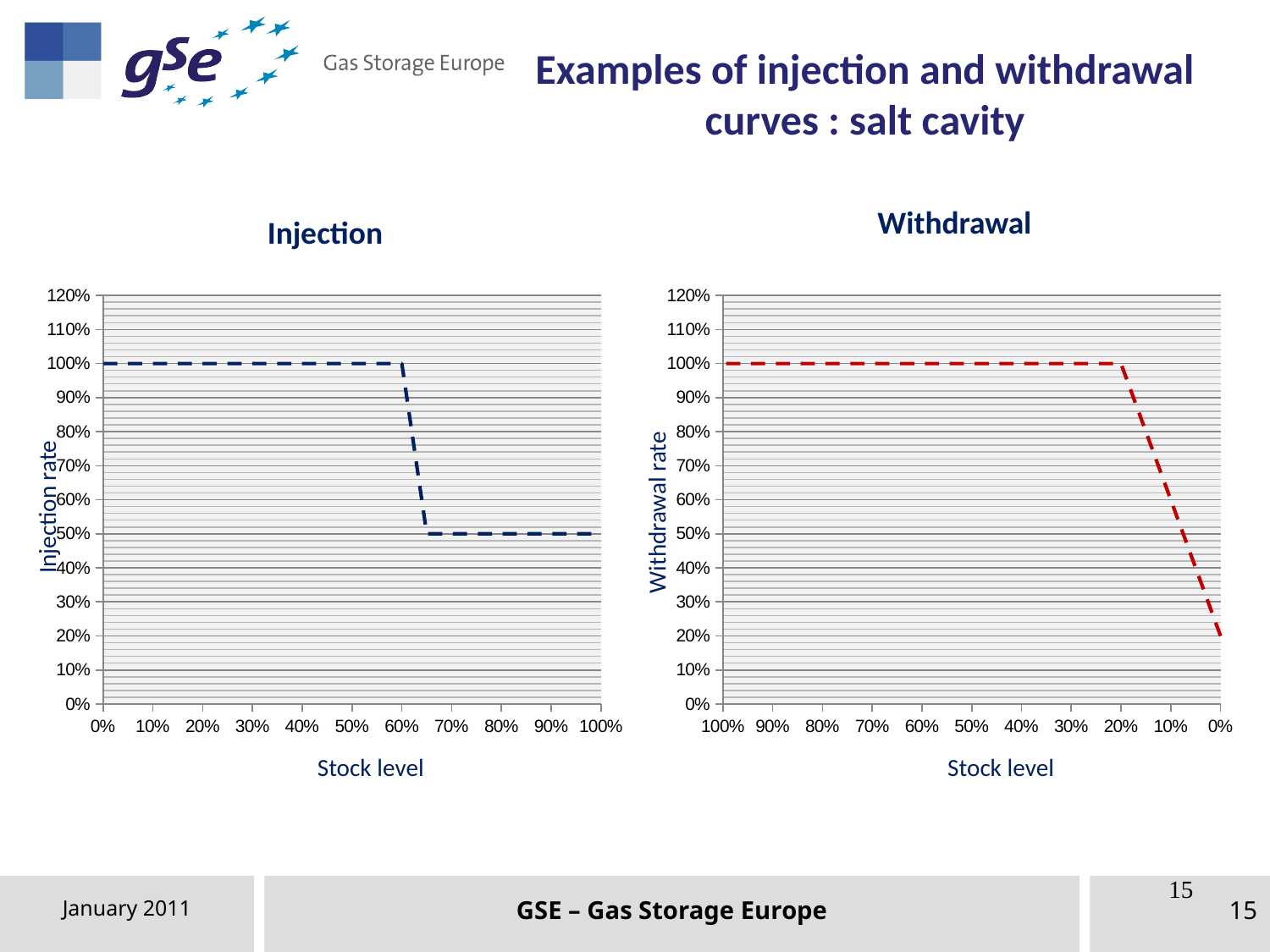
In the Injection chart, what is the injection rate at a stock level of 90%? 50% In the Withdrawal chart, is the withdrawal rate at a stock level of 10% greater or less than 80%? less What colour is the dashed line in the Withdrawal chart? red In the Withdrawal chart, what is the withdrawal rate at a stock level of 0%? 20% In the Injection chart, what is the injection rate at a stock level of 30%? 100% In the Injection chart, does the injection rate rise or fall as the stock level increases from 60% to 70%? fall In the Withdrawal chart, which is larger: the withdrawal rate at a stock level of 40% or at 0%? 40% In the Withdrawal chart, does the withdrawal rate rise or fall as the stock level goes from 20% to 0%? fall What is the x-axis title of the Injection chart? Stock level What kind of chart is the Injection chart? line chart In the Withdrawal chart, what is the withdrawal rate at a stock level of 50%? 100% In the Injection chart, is the injection rate at a stock level of 80% greater or less than 60%? less